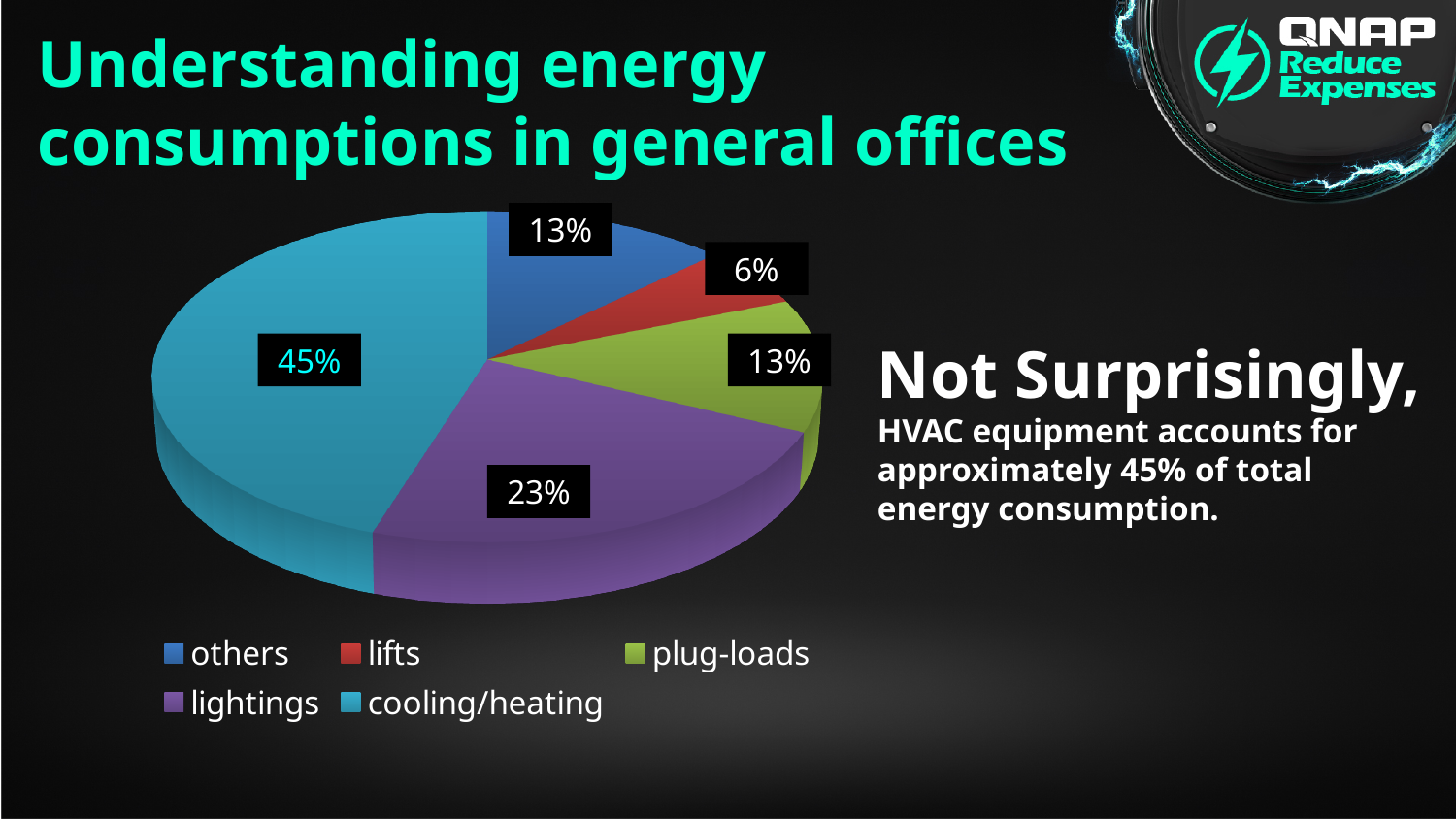
How many categories does the pie chart show? 5 Which category has the largest slice of the pie? cooling/heating Which is larger, the share for lightings or the share for plug-loads? lightings What share of energy consumption does lifts account for? 6% What is the difference in percentage points between cooling/heating and lightings? 22 Which category has the smallest slice of the pie? lifts Which colour represents cooling/heating in the legend? cyan What share of energy consumption does cooling/heating account for? 45% What is the combined share of others and lifts? 19% What share of energy consumption does plug-loads account for? 13% What kind of chart is shown on the slide? pie chart